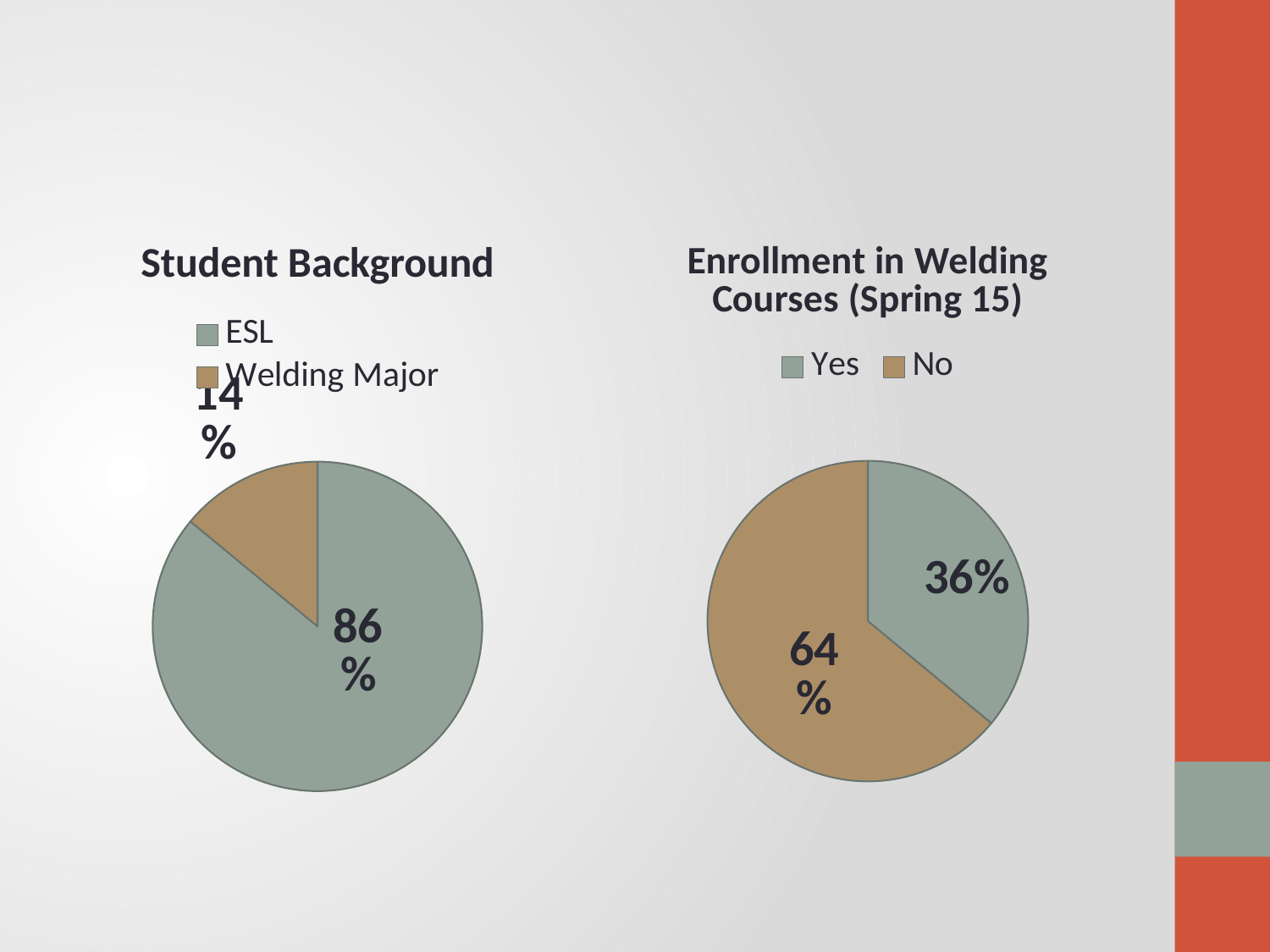
What kind of chart is the 'Enrollment in Welding Courses (Spring 15)' chart? Pie chart How many categories does the 'Student Background' chart show? 2 In the 'Student Background' chart, what is the difference between the ESL and Welding Major shares? 72% In the 'Student Background' chart, which category has the smallest slice? Welding Major In the 'Enrollment in Welding Courses (Spring 15)' chart, what share of the pie is Yes? 36% In the 'Enrollment in Welding Courses (Spring 15)' chart, which is larger, Yes or No? No In the 'Student Background' chart, what share of the pie is ESL? 86% In the 'Enrollment in Welding Courses (Spring 15)' chart, what share of the pie is No? 64% In the 'Enrollment in Welding Courses (Spring 15)' chart, what is the difference between the No and Yes shares? 28% What is the title of the chart on the right side of the slide? Enrollment in Welding Courses (Spring 15) In the 'Student Background' chart, which category has the largest slice? ESL